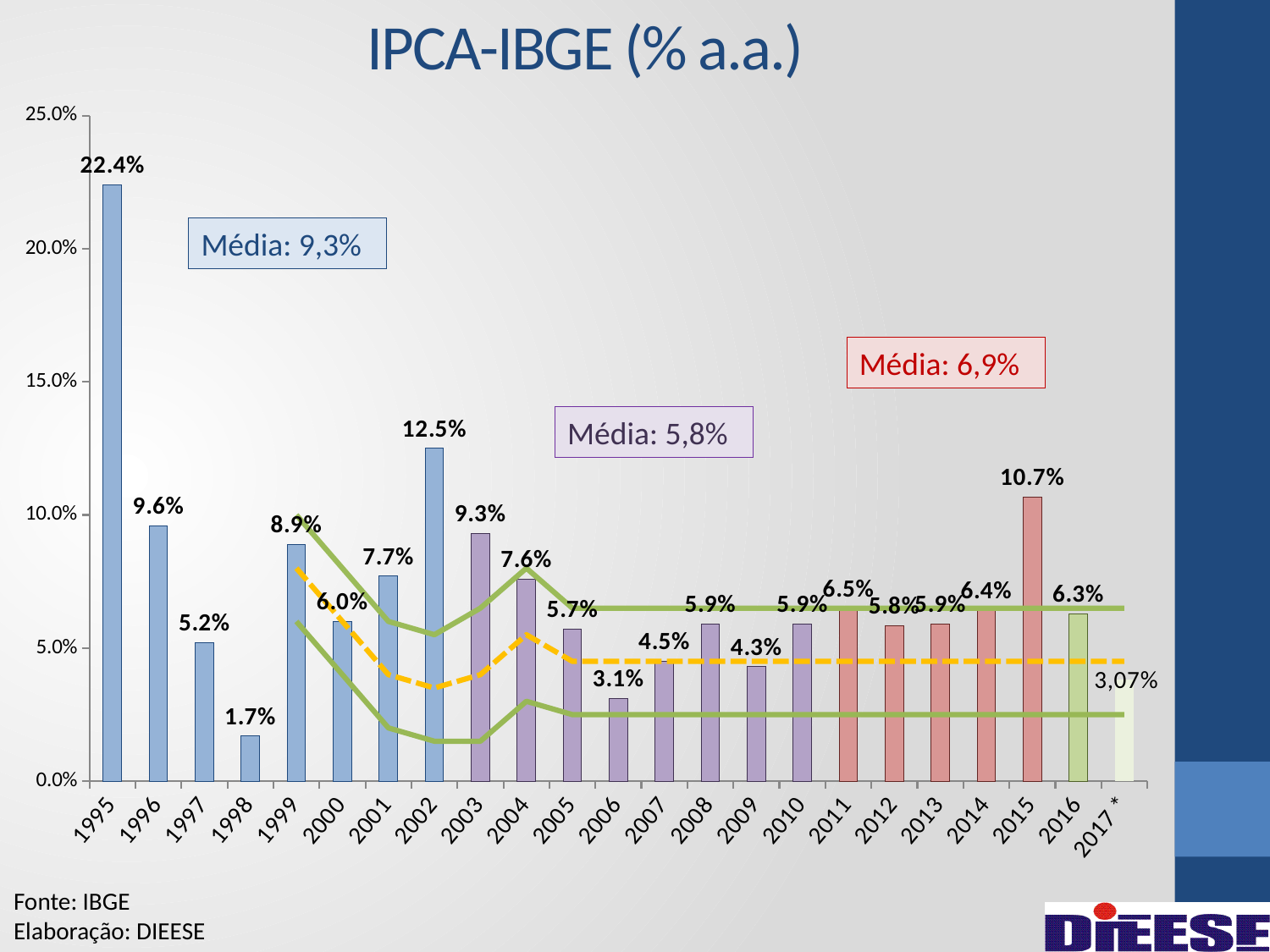
Which year has the highest IPCA value? 1995 What is the difference between the IPCA values for 2015 and 2016? 4.4% Is the value for 2006 greater or less than 5.0%? less What is the value shown for 2017*? 3,07% What is the title of the chart? IPCA-IBGE (% a.a.) What is the IPCA value shown for 1995? 22.4% What is the IPCA value shown for 2015? 10.7% What is the IPCA value shown for 2002? 12.5% How many years are shown on the x axis? 23 Which year has the lowest IPCA value? 1998 Which year has a higher IPCA value, 2003 or 2004? 2003 What kind of chart is shown on the slide? Combination bar and line chart